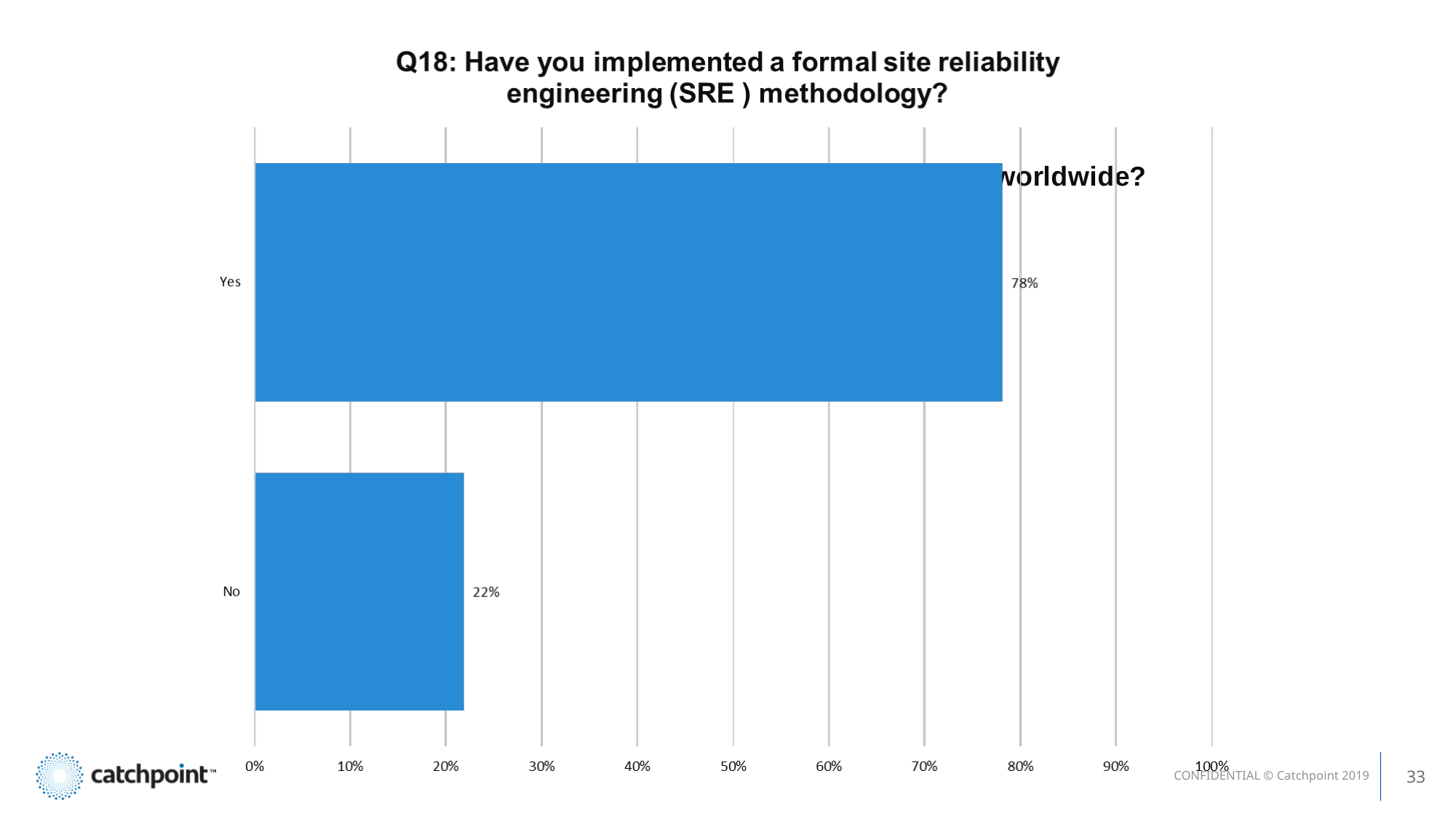
What percentage of respondents answered No? 22% What is the maximum value shown on the x axis? 100% Is the value for No greater or less than 30%? less Which response has the lowest value? No What is the title of the chart? Q18: Have you implemented a formal site reliability engineering (SRE ) methodology? What kind of chart is shown on the slide? bar chart What percentage of respondents answered Yes? 78% Which is larger, the value for Yes or the value for No? Yes What is the difference between the Yes and No percentages? 56% Is the value for Yes greater or less than 70%? greater Which response has the highest value? Yes How many response categories are shown in the chart? 2